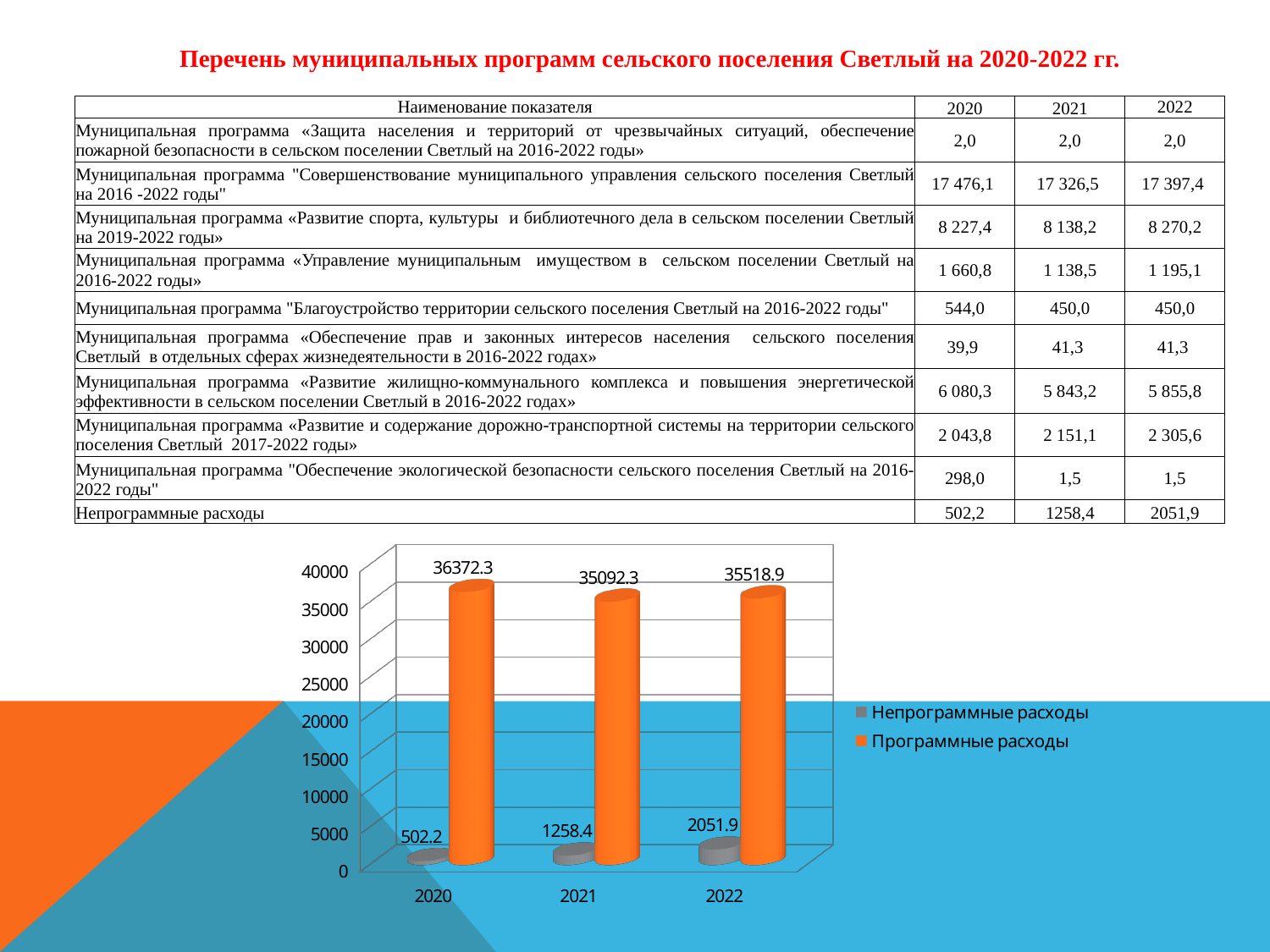
What is the difference between Программные расходы in 2020 and 2021 in the chart? 1280.0 What is the value of Программные расходы for 2022 in the chart? 35518.9 What type of chart is shown on the slide? bar chart What is the value of Программные расходы for 2020 in the chart? 36372.3 In which year are Программные расходы highest in the chart? 2020 Do Непрограммные расходы rise or fall from 2020 to 2022 in the chart? rise Which is larger in the chart: Программные расходы in 2021 or in 2022? 2022 How many years are shown on the x axis of the chart? 3 How many series does the chart legend list? 2 What is the difference between Непрограммные расходы in 2022 and 2020 in the chart? 1549.7 In which year are Непрограммные расходы lowest in the chart? 2020 What is the value of Непрограммные расходы for 2021 in the chart? 1258.4